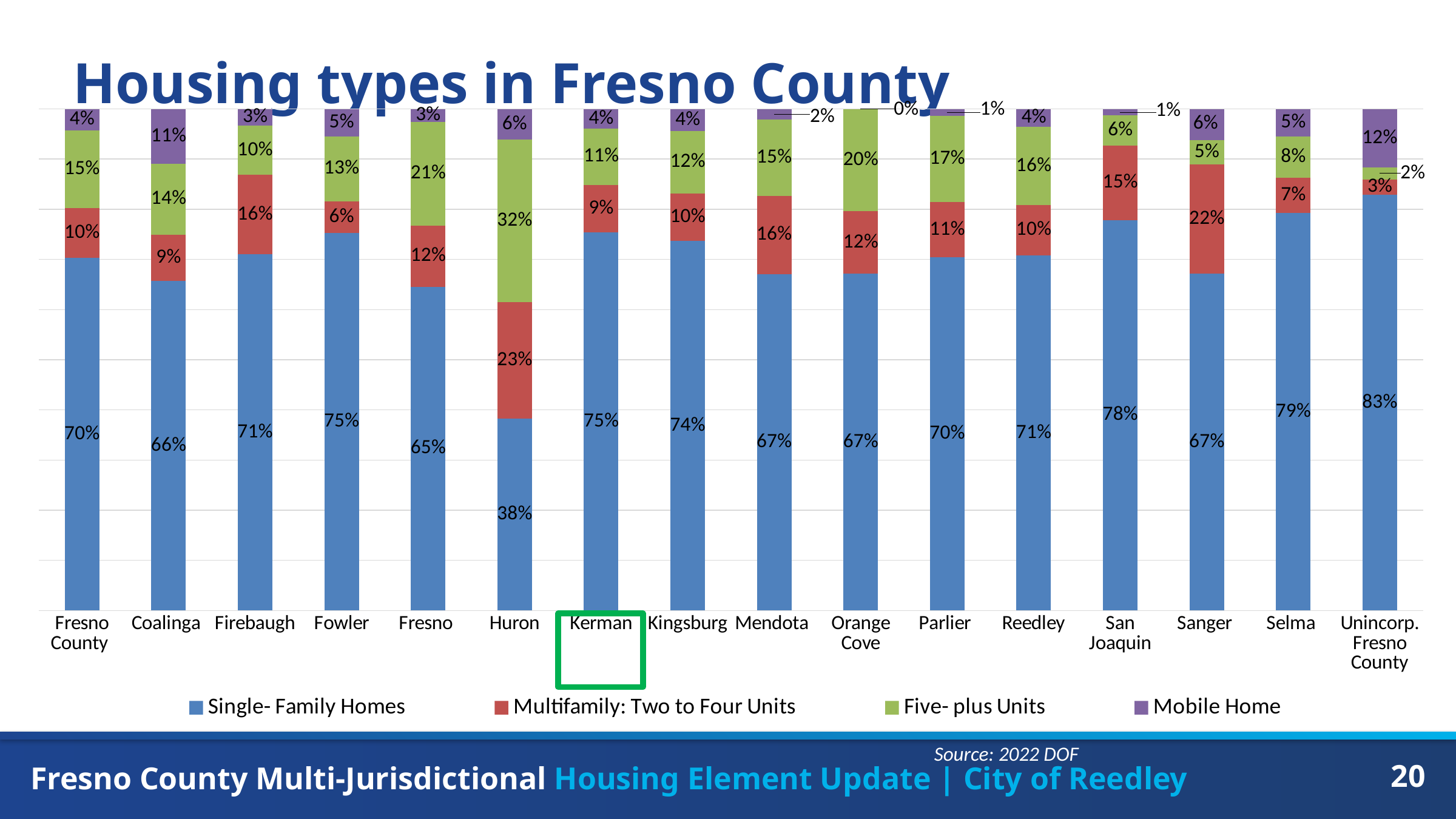
What kind of chart is shown on the slide? Stacked bar chart What is the title of the chart? Housing types in Fresno County What percentage of housing in Reedley is Single-Family Homes? 71% How many categories are shown on the x axis? 16 Which category has the lowest Single-Family Homes share? Huron What is the Multifamily: Two to Four Units share for Sanger? 22% What is the difference between the Single-Family Homes share in Selma and in Huron? 41% How many series does the legend list? 4 Which has a larger Five-plus Units share, Fresno or Orange Cove? Fresno What is the Mobile Home share for Coalinga? 11% Which category has the highest Single-Family Homes share? Unincorp. Fresno County What is the Five-plus Units share for Huron? 32%